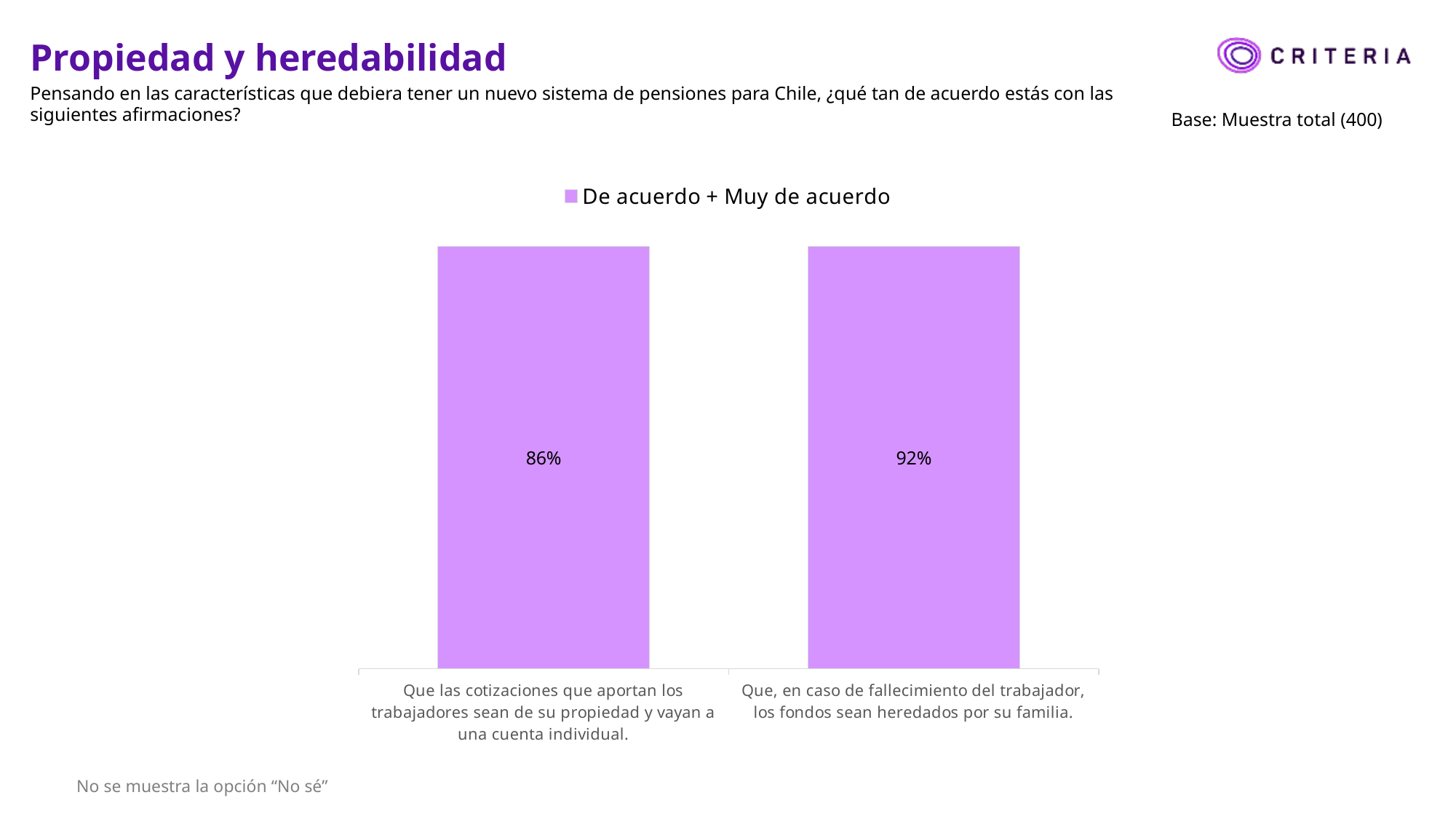
Which statement has the highest level of agreement? Que, en caso de fallecimiento del trabajador, los fondos sean heredados por su familia. Which is larger: the value for the statement about contributions being the worker's property, or the value for the statement about funds being inherited by the family? Funds being inherited by the family (92%) What is the legend entry for the series shown? De acuerdo + Muy de acuerdo Do the values rise or fall from left to right? Rise What is the value for "Que, en caso de fallecimiento del trabajador, los fondos sean heredados por su familia"? 92% What is the value for "Que las cotizaciones que aportan los trabajadores sean de su propiedad y vayan a una cuenta individual"? 86% How many series does the legend list? 1 How many categories are shown in the chart? 2 Which statement has the lowest level of agreement? Que las cotizaciones que aportan los trabajadores sean de su propiedad y vayan a una cuenta individual. What is the difference between the two bars' values? 6% What is the base (sample size) stated on the slide? Muestra total (400) What kind of chart is shown on the slide? Bar chart